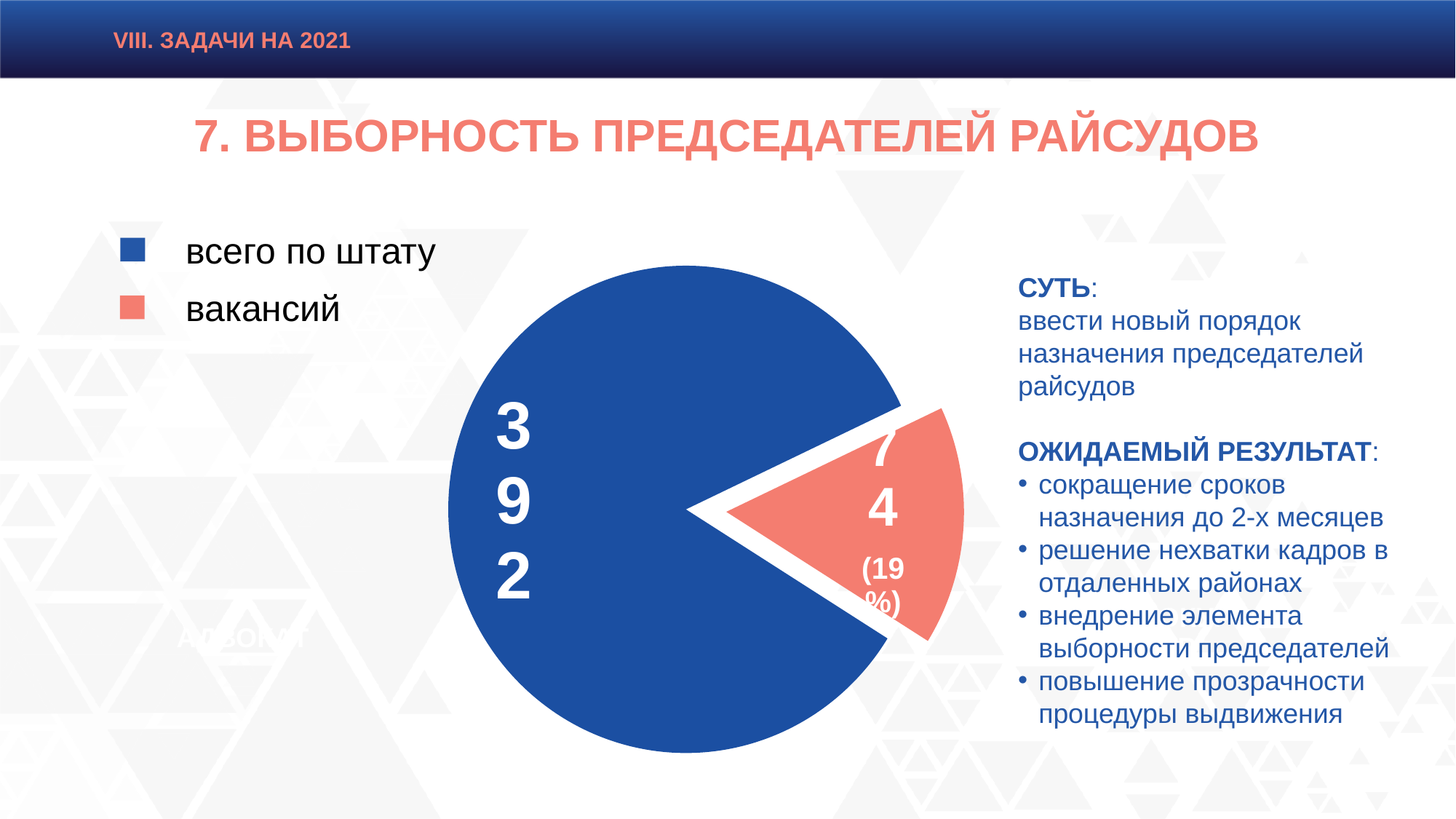
Which is larger, the value for "всего по штату" or the value for "вакансий"? всего по штату What colour is the "вакансий" slice? red (salmon) Which legend entry is shown in blue? всего по штату What kind of chart is shown on the slide? pie chart How many slices does the pie chart have? 2 Which slice of the pie chart is the smallest? вакансий What value is shown for the "вакансий" slice? 74 What is the difference between the values for "всего по штату" and "вакансий"? 318 Which slice of the pie chart is the largest? всего по штату What value is shown for the "всего по штату" slice? 392 How many entries does the legend list? 2 What percentage is printed on the "вакансий" slice? 19%